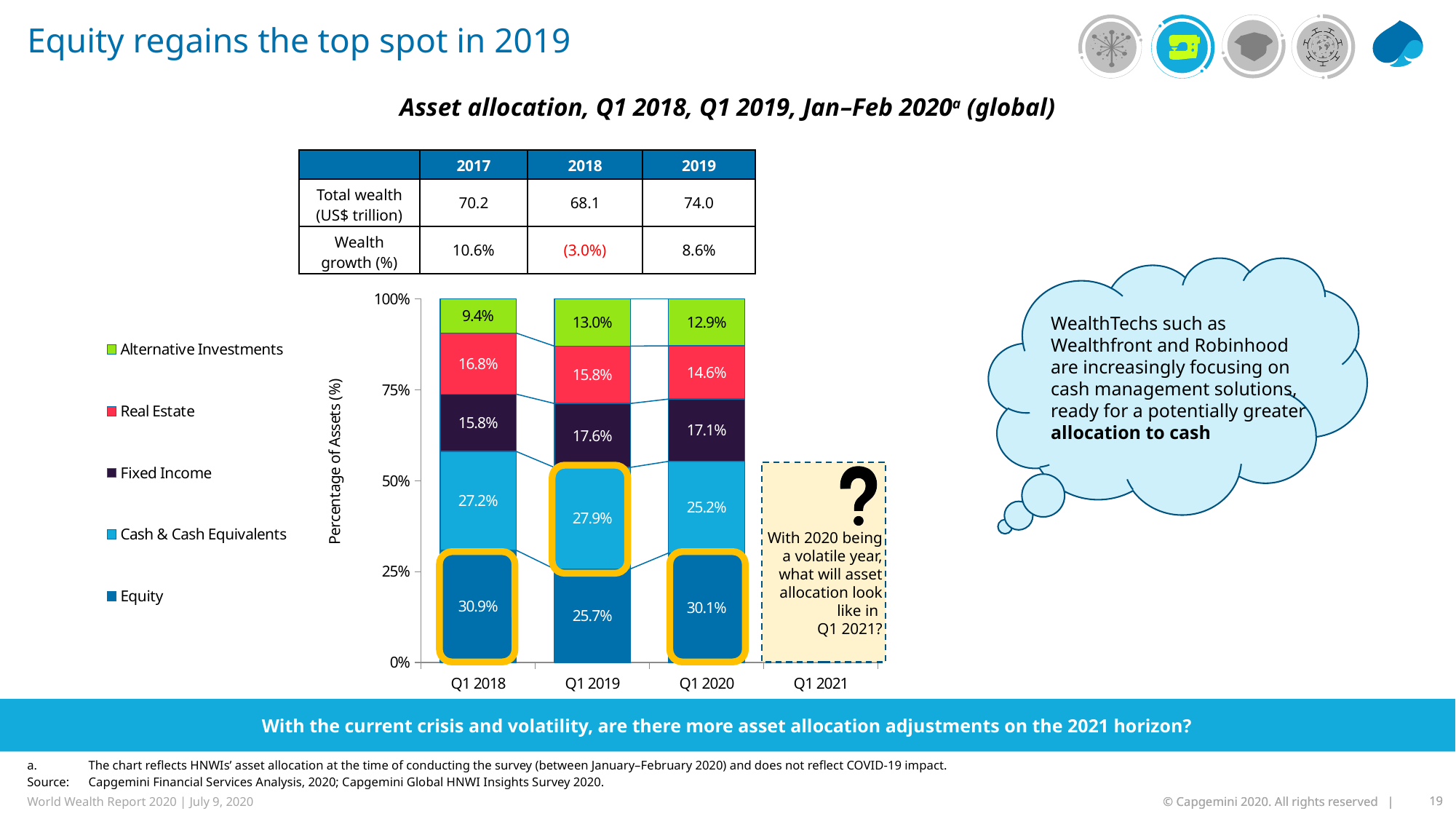
How many quarters have plotted allocation data in the chart? 3 What was the Fixed Income allocation in Q1 2019? 17.6% Does the Real Estate share rise or fall from Q1 2018 to Q1 2020? fall What share of assets did Alternative Investments hold in Q1 2020? 12.9% What kind of chart is shown on the slide? stacked bar chart Which asset class had the largest share in Q1 2020? Equity How many series does the legend list? 5 What was the Cash & Cash Equivalents share in Q1 2019? 27.9% By how many percentage points did the Equity share fall from Q1 2018 to Q1 2019? 5.2 percentage points Which asset class had the smallest share in Q1 2018? Alternative Investments What percentage of assets was allocated to Equity in Q1 2018? 30.9% Which was larger in Q1 2019: the Equity share or the Cash & Cash Equivalents share? Cash & Cash Equivalents